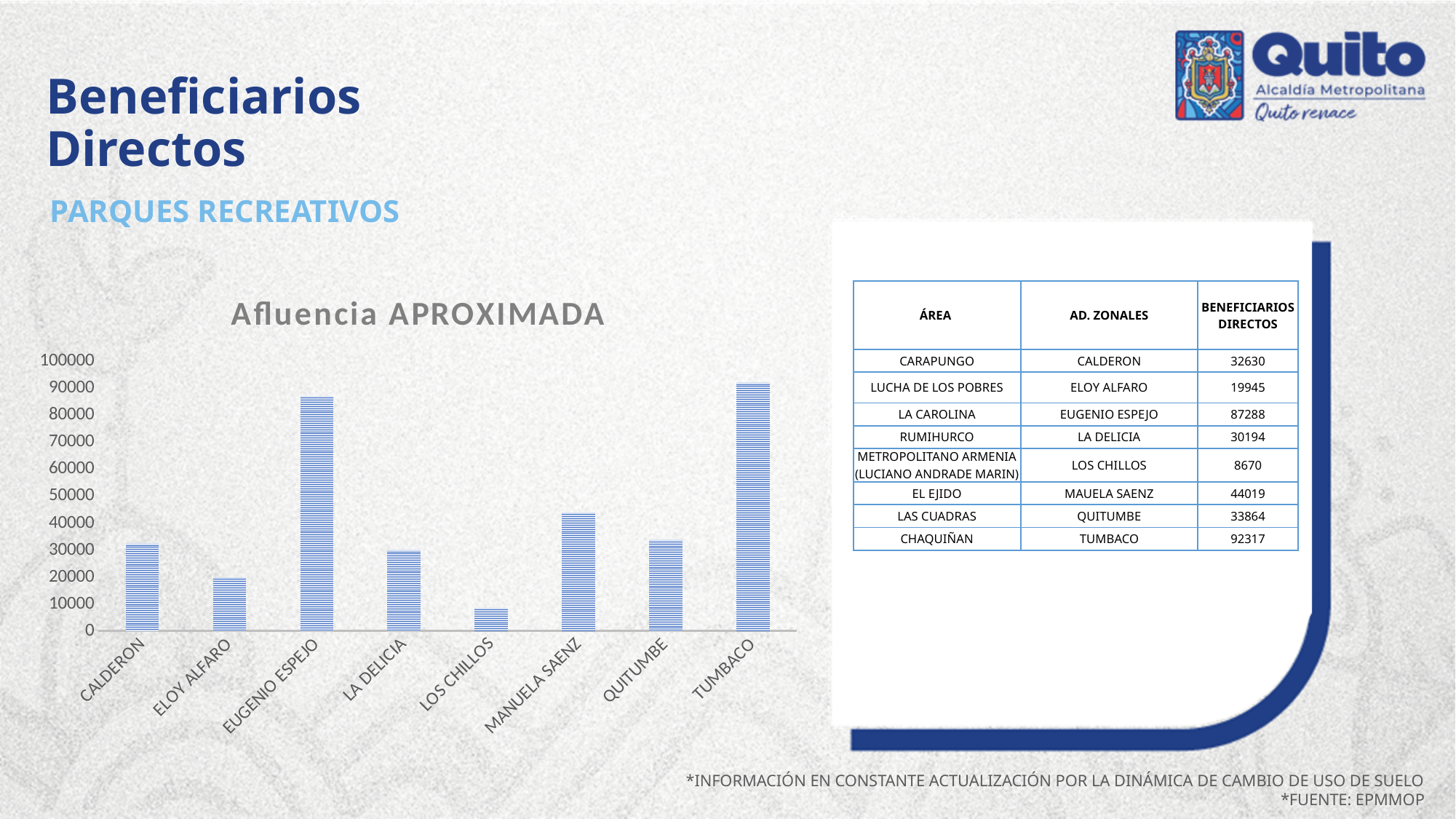
Which category has the highest bar in the "Afluencia APROXIMADA" chart? TUMBACO In the "Afluencia APROXIMADA" chart, is the value for LOS CHILLOS greater or less than 10000? less Which category has the lowest bar in the "Afluencia APROXIMADA" chart? LOS CHILLOS According to the table on the slide, what is the number of beneficiarios directos for TUMBACO, the highest bar in the chart? 92317 In the "Afluencia APROXIMADA" chart, is the value for MANUELA SAENZ greater or less than 40000? greater According to the table on the slide, what is the number of beneficiarios directos for LOS CHILLOS, the lowest bar in the chart? 8670 In the "Afluencia APROXIMADA" chart, which is larger, EUGENIO ESPEJO or MANUELA SAENZ? EUGENIO ESPEJO What is the title of the bar chart on the slide? Afluencia APROXIMADA In the "Afluencia APROXIMADA" chart, which is larger, CALDERON or ELOY ALFARO? CALDERON In the "Afluencia APROXIMADA" chart, is the value for TUMBACO greater or less than 90000? greater How many categories are shown on the x axis of the "Afluencia APROXIMADA" chart? 8 What kind of chart is shown under the title "Afluencia APROXIMADA"? bar chart